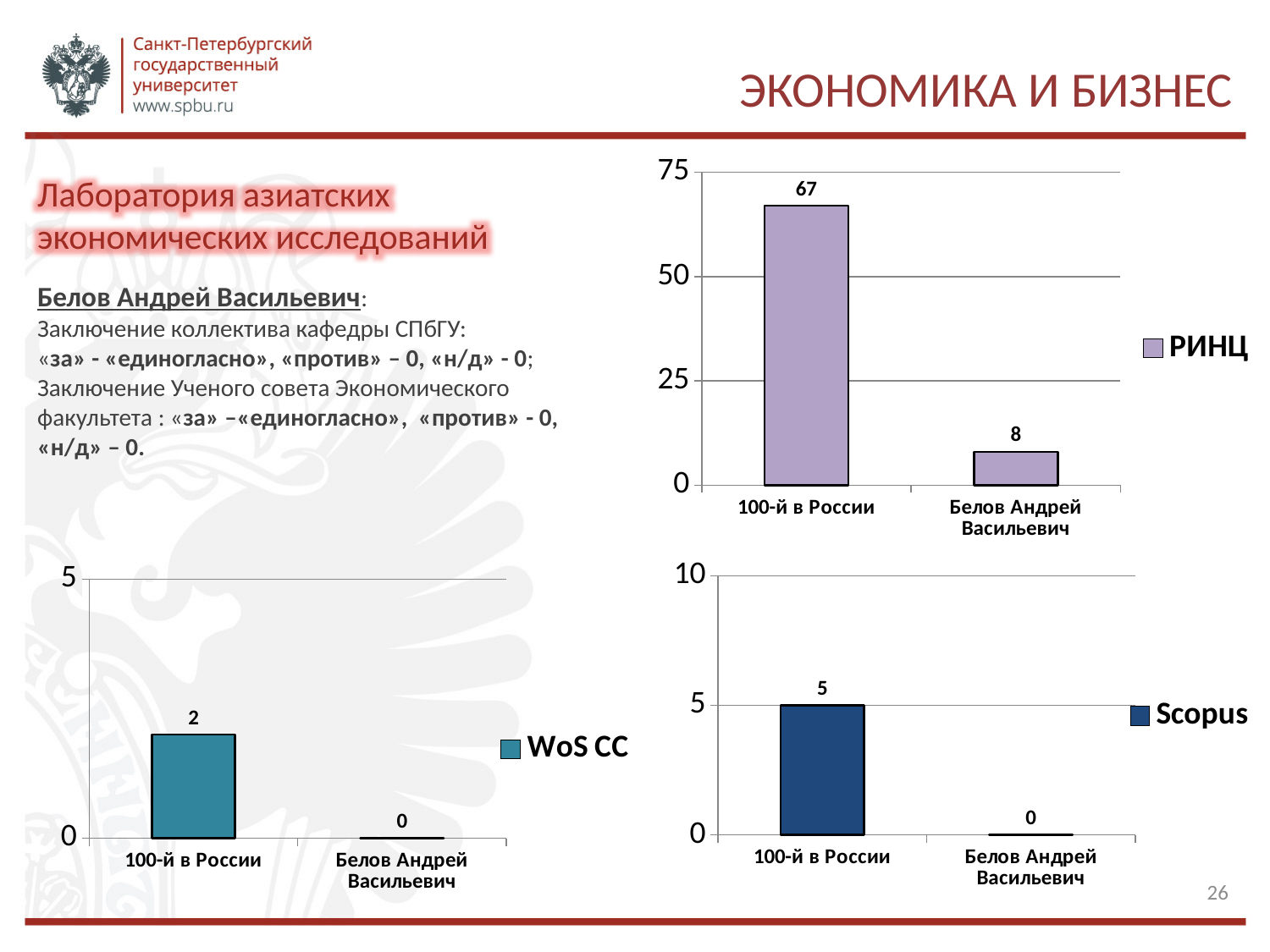
In the WoS CC chart, what is the value for 100-й в России? 2 In the РИНЦ chart, is the value for 100-й в России greater or less than 50? greater In the Scopus chart, what is the value for Белов Андрей Васильевич? 0 In the WoS CC chart, what is the value for Белов Андрей Васильевич? 0 How many series does the legend of the РИНЦ chart list? 1 How many categories are shown in the WoS CC chart? 2 In the Scopus chart, which category has the higher value? 100-й в России What kind of chart is the Scopus chart? bar chart In the РИНЦ chart, what is the value for 100-й в России? 67 In the РИНЦ chart, what is the difference between the values for 100-й в России and Белов Андрей Васильевич? 59 In the РИНЦ chart, what is the value for Белов Андрей Васильевич? 8 In the Scopus chart, what is the value for 100-й в России? 5